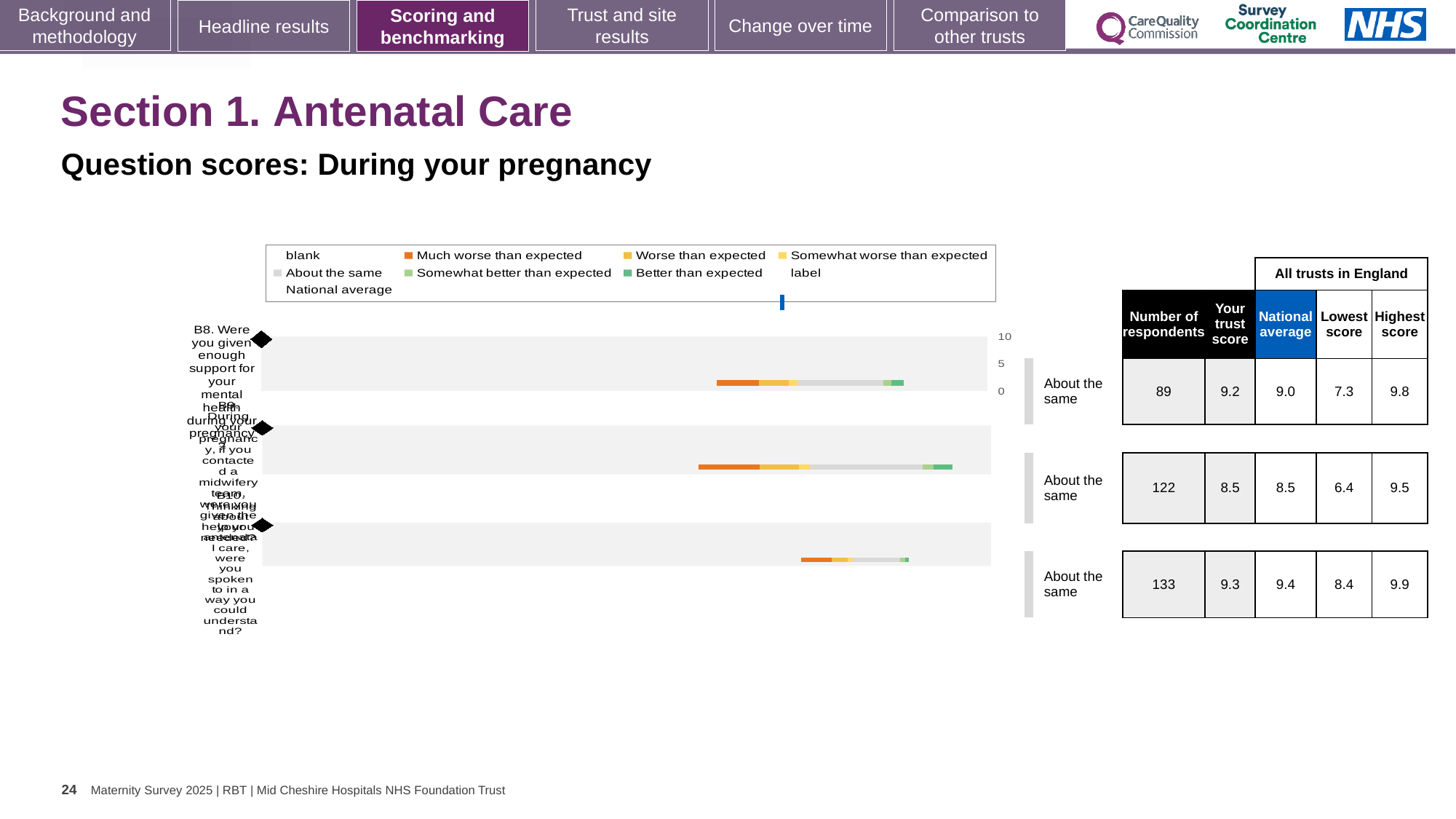
Which question row has the highest trust score? The third row (9.3) What benchmark category is shown for all three question rows? About the same Which question row has the fewest respondents? The first row, B8 (89) What is the trust score for the first question row (B8)? 9.2 How many question rows are plotted in the chart? 3 What is the national average for the second question row? 8.5 What colour represents 'Much worse than expected' in the legend? Orange For the third question row, what is the difference between the highest score and the lowest score? 1.5 What is the lowest score among all trusts in England for the second question row? 6.4 What kind of chart is shown on the slide? Bar chart For the first question row (B8), which is larger: the trust score or the national average? The trust score (9.2) What is the number of respondents for the first question row (B8, support for mental health during pregnancy)? 89